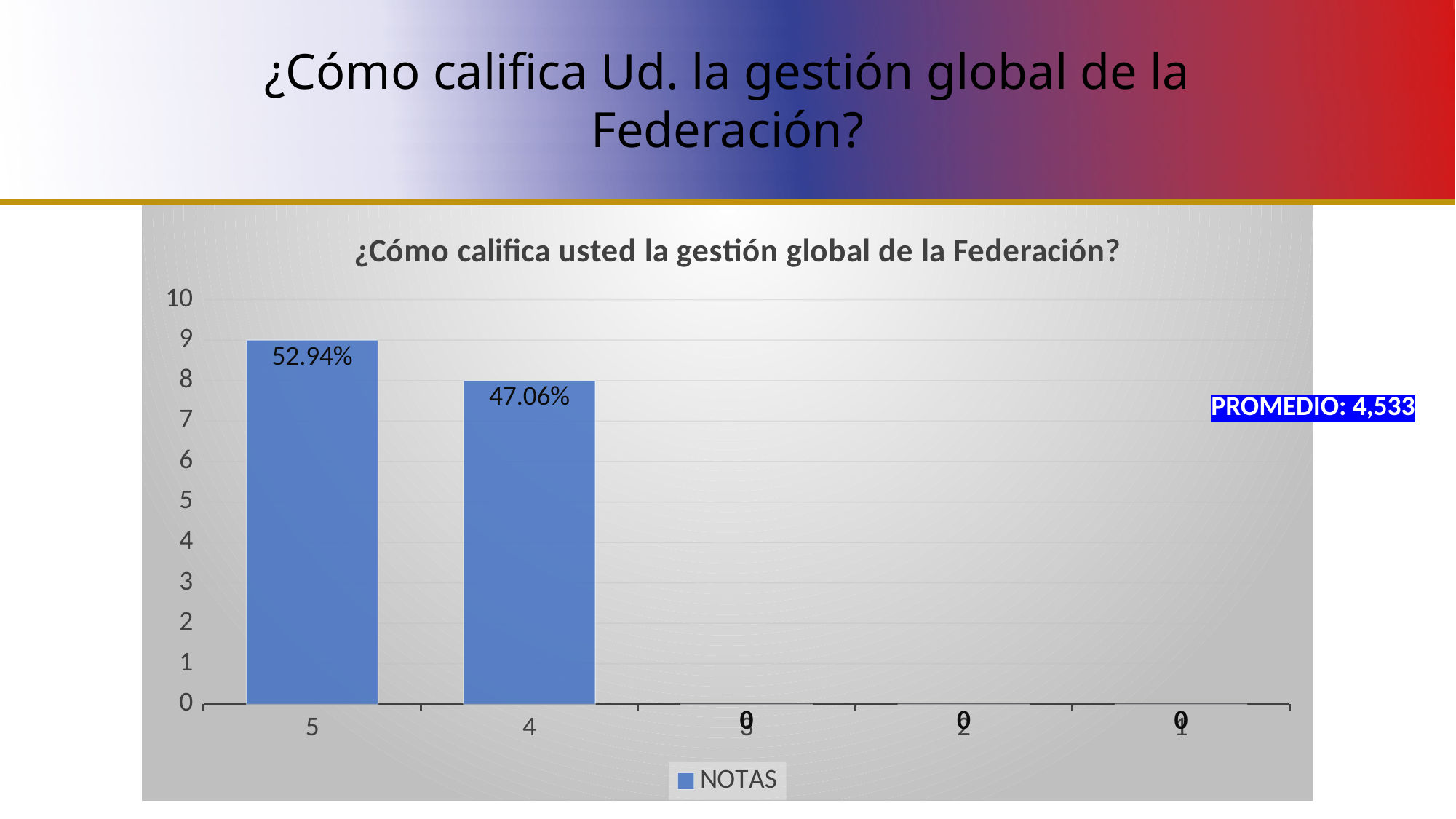
How many series does the legend list? 1 What data label is shown on the bar for category 4? 47.06% Which category has the highest bar? 5 Which of the two bars is taller, category 5 or category 4? 5 What data label is shown on the bar for category 5? 52.94% What value on the vertical axis does the bar for category 4 reach? 8 What kind of chart is shown on the slide? bar chart How many categories are shown on the horizontal axis? 5 What value on the vertical axis does the bar for category 5 reach? 9 What is the name of the series shown in the legend? NOTAS What is the difference between the data labels for category 5 and category 4? 5.88% What data label is shown for category 3? 0